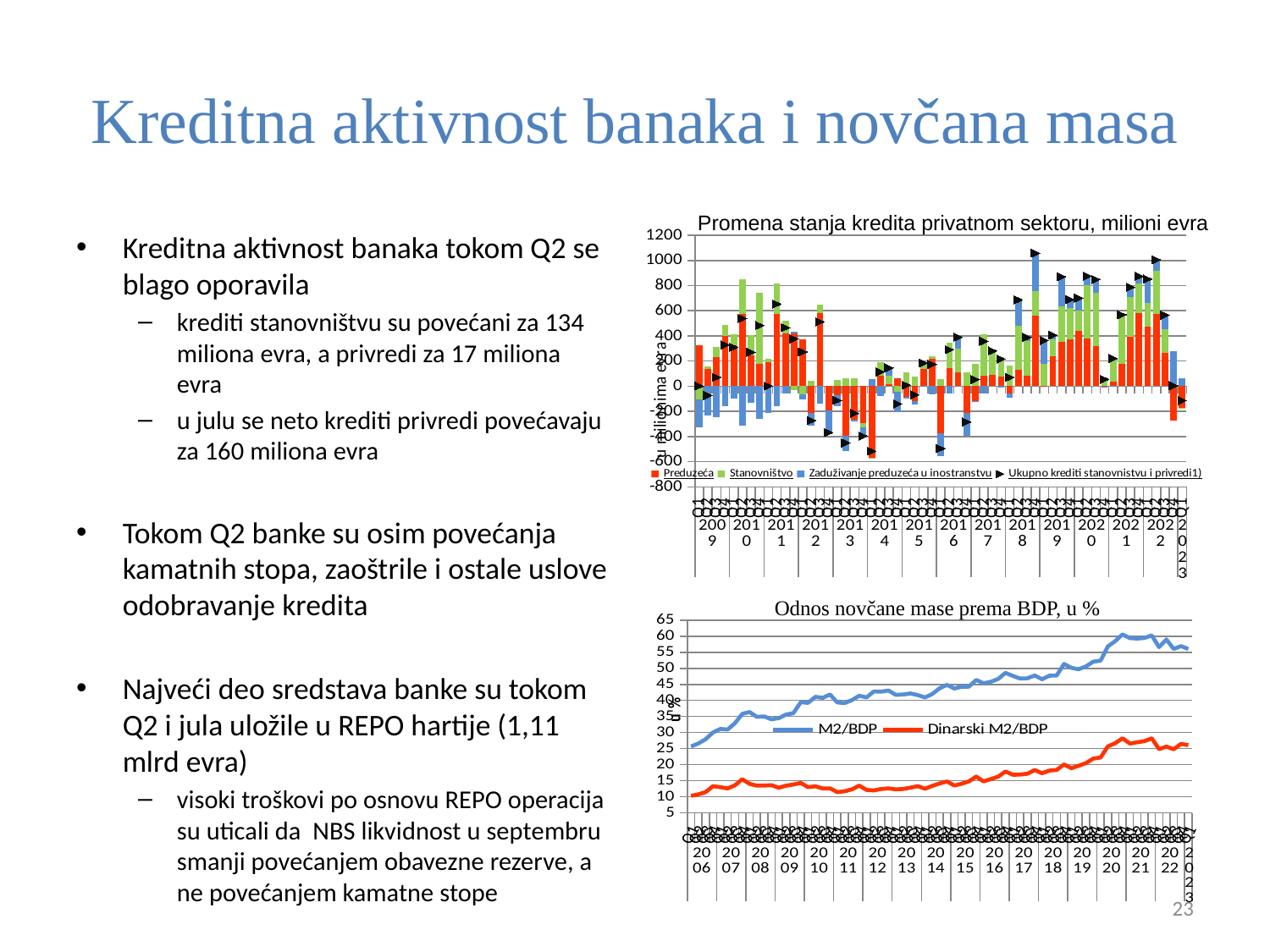
In the bottom chart, 'Odnos novčane mase prema BDP', is the Dinarski M2/BDP value at the start of 2006 greater or less than 15? less In the bottom chart, 'Odnos novčane mase prema BDP', is the M2/BDP value at the start of 2006 greater or less than 30? less How many series does the legend of the bottom chart, 'Odnos novčane mase prema BDP', list? 2 In the bottom chart, 'Odnos novčane mase prema BDP', is the peak value of M2/BDP in 2021 greater or less than 55? greater What kind of chart is the top chart, 'Promena stanja kredita privatnom sektoru'? bar chart How many series does the legend of the top chart, 'Promena stanja kredita privatnom sektoru', list? 4 In the bottom chart, 'Odnos novčane mase prema BDP', does the M2/BDP series generally rise or fall from 2006 to 2022? rise What is the title of the top chart on the slide? Promena stanja kredita privatnom sektoru, milioni evra In the bottom chart, 'Odnos novčane mase prema BDP', which series is higher throughout the period: M2/BDP or Dinarski M2/BDP? M2/BDP In the top chart, 'Promena stanja kredita privatnom sektoru', which series is shown in green? Stanovništvo What kind of chart is the bottom chart, 'Odnos novčane mase prema BDP, u %'? line chart